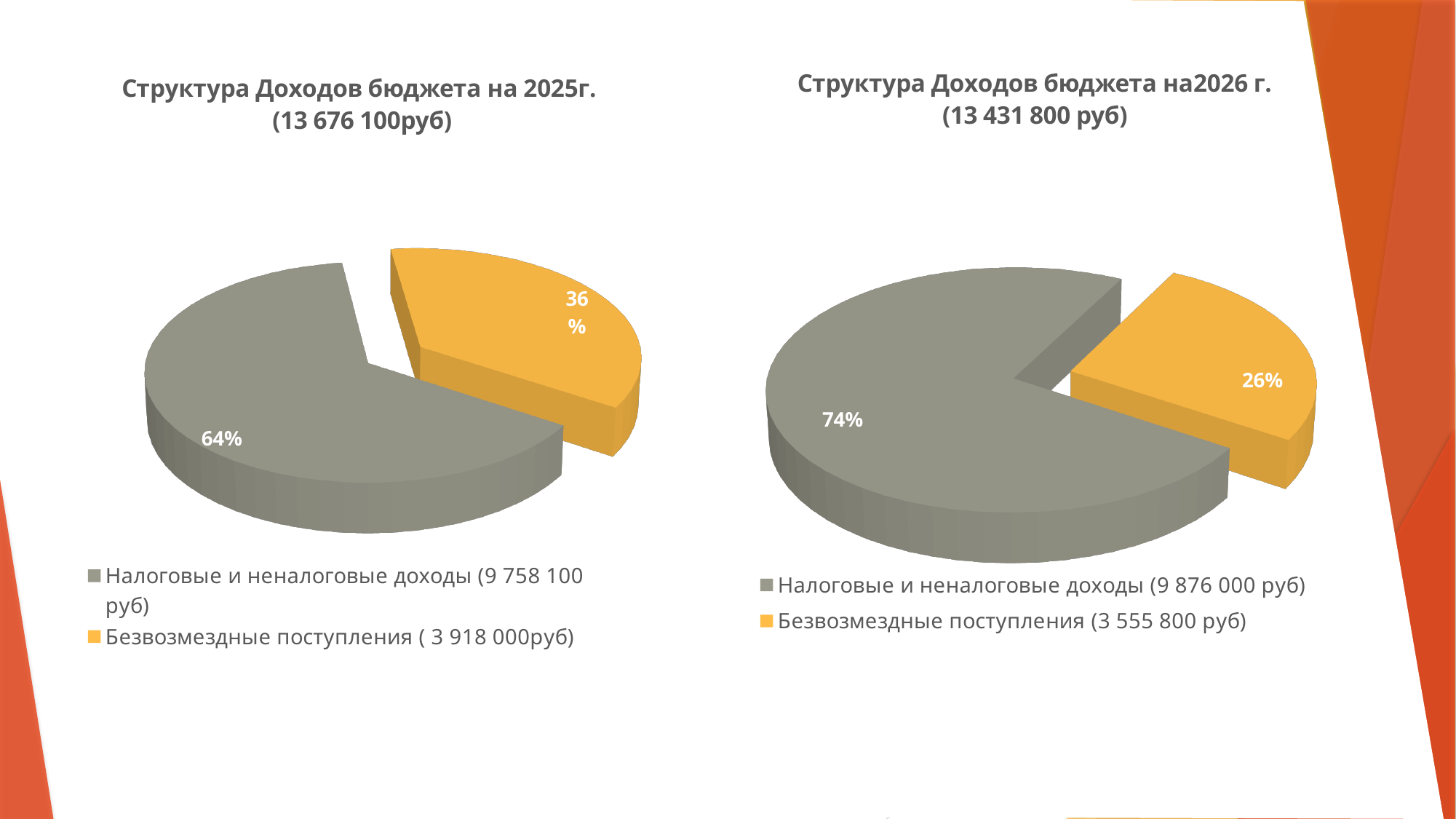
In the chart 'Структура Доходов бюджета на 2025г.', what is the difference in percentage points between the two slices? 28 In the chart 'Структура Доходов бюджета на 2025г.', what colour is the slice for 'Безвозмездные поступления'? Orange In the chart 'Структура Доходов бюджета на2026 г.', what share of the pie is 'Налоговые и неналоговые доходы'? 74% In the chart 'Структура Доходов бюджета на 2025г.', what share of the pie is 'Безвозмездные поступления'? 36% In the chart 'Структура Доходов бюджета на2026 г.', what is the difference in percentage points between the two slices? 48 In the chart 'Структура Доходов бюджета на 2025г.', which category has the largest slice? Налоговые и неналоговые доходы In the chart 'Структура Доходов бюджета на2026 г.', what share of the pie is 'Безвозмездные поступления'? 26% In the chart 'Структура Доходов бюджета на2026 г.', which category has the smallest slice? Безвозмездные поступления What kind of chart is the left chart on the slide? Pie chart How many categories does the chart 'Структура Доходов бюджета на2026 г.' show? 2 Which is larger: the share of 'Безвозмездные поступления' in the 2025 chart or in the 2026 chart? 2025 chart